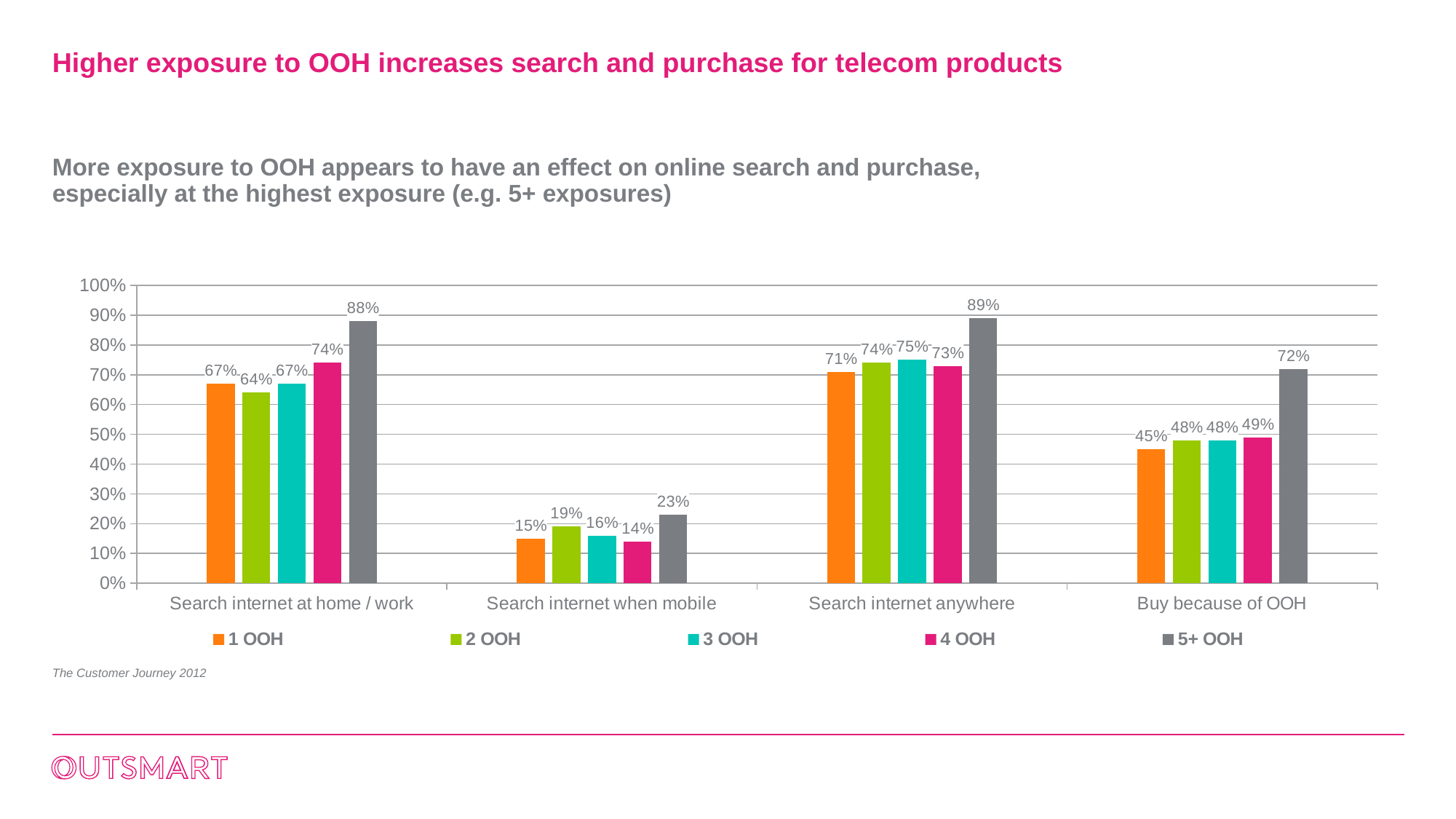
Which series has the lowest value in the Search internet when mobile category? 4 OOH What is the difference between the 5+ OOH and 1 OOH values in the Buy because of OOH category? 27% How many categories are shown on the x axis? 4 How many series does the legend list? 5 Which series has the highest value in the Search internet anywhere category? 5+ OOH Which is larger in the Search internet at home / work category: the 4 OOH value or the 2 OOH value? 4 OOH What is the value for 1 OOH in the Buy because of OOH category? 45% What is the value for 5+ OOH in the Search internet at home / work category? 88% What is the value for 2 OOH in the Search internet when mobile category? 19% What is the value for 3 OOH in the Search internet anywhere category? 75% What kind of chart is shown on the slide? Bar chart Which legend entry is shown in grey? 5+ OOH